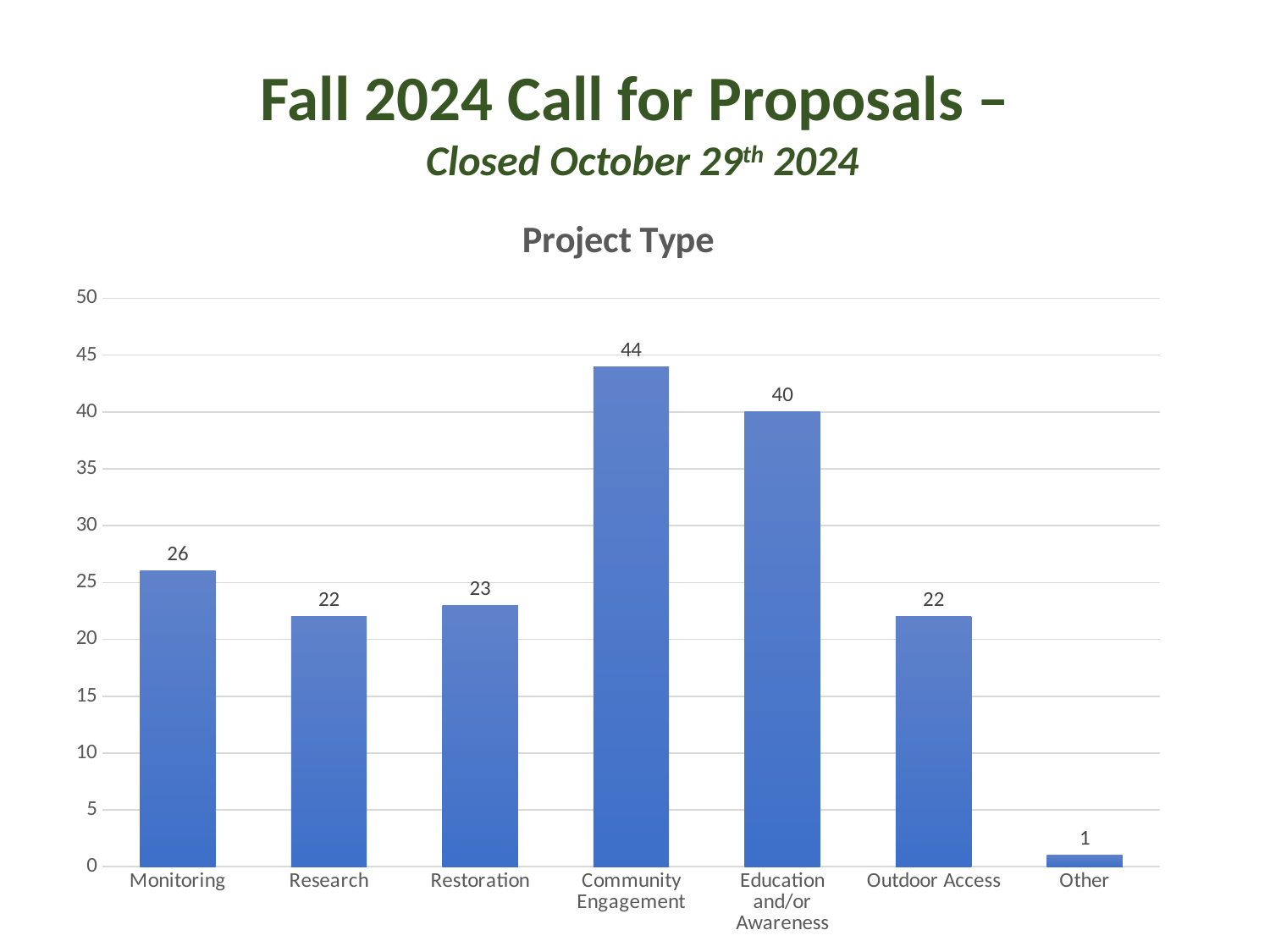
What is the difference between the values for Community Engagement and Education and/or Awareness? 4 What is the value for Monitoring? 26 Which is larger, the value for Restoration or the value for Outdoor Access? Restoration What is the value for Community Engagement? 44 What is the difference between the values for Monitoring and Research? 4 Which project type has the lowest value? Other What kind of chart is shown on the slide? Bar chart What is the value for Education and/or Awareness? 40 Which project type has the highest value? Community Engagement What is the value for Other? 1 How many project type categories are shown on the chart? 7 What is the title of the chart? Project Type